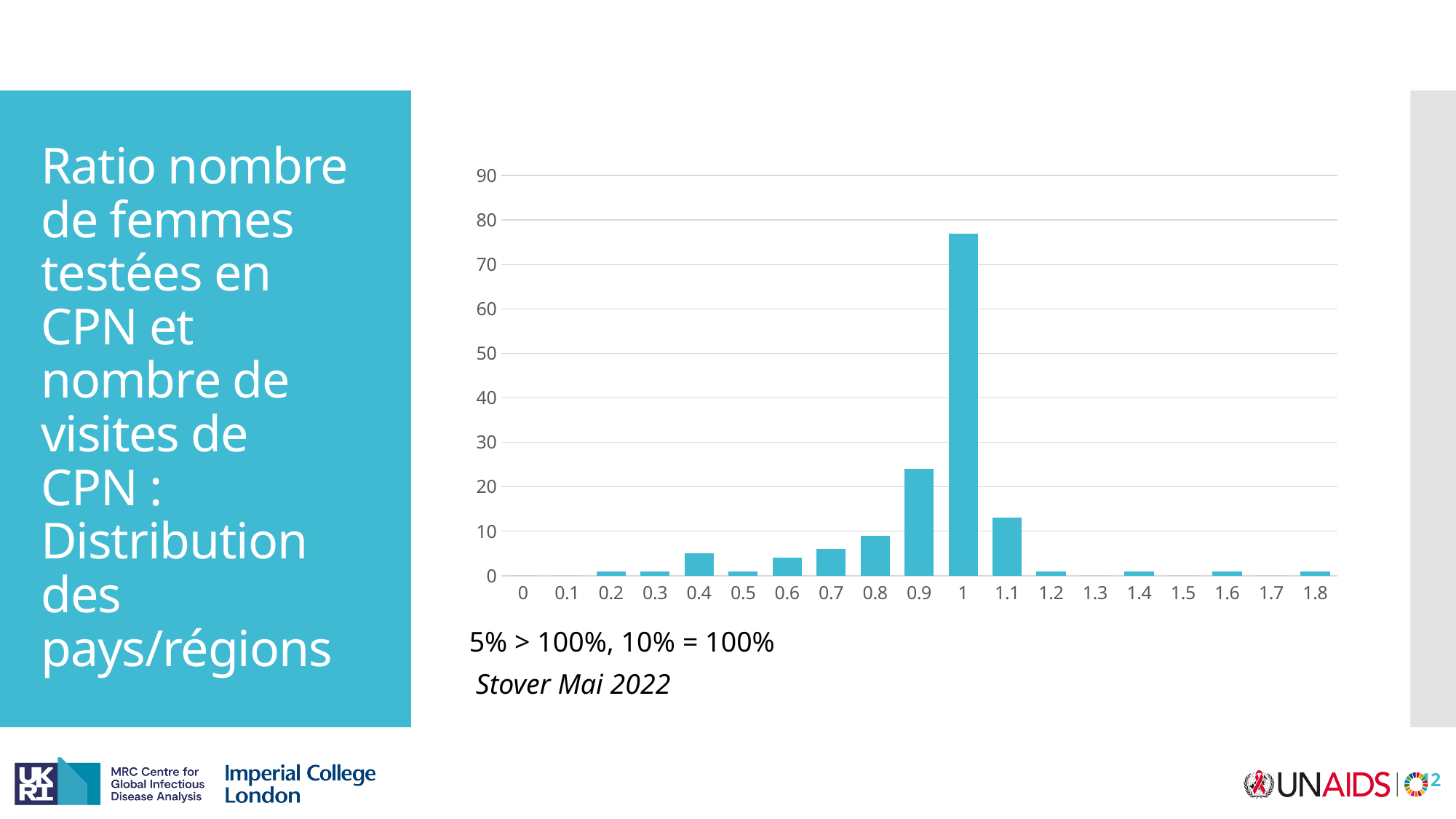
Is the value for category 1 greater or less than 70? greater Which is larger, the value for category 0.9 or the value for category 1.1? 0.9 Do the values rise or fall along the x axis from category 0.4 to category 1? rise Is the value for category 0.9 greater or less than 20? greater Is the value for category 0.9 greater or less than 30? less What kind of chart is shown on the slide? bar chart What source is cited below the chart? Stover Mai 2022 Which x-axis category has the highest bar? 1 How many categories are labelled on the x axis? 19 Which is larger, the value for category 0.7 or the value for category 0.8? 0.8